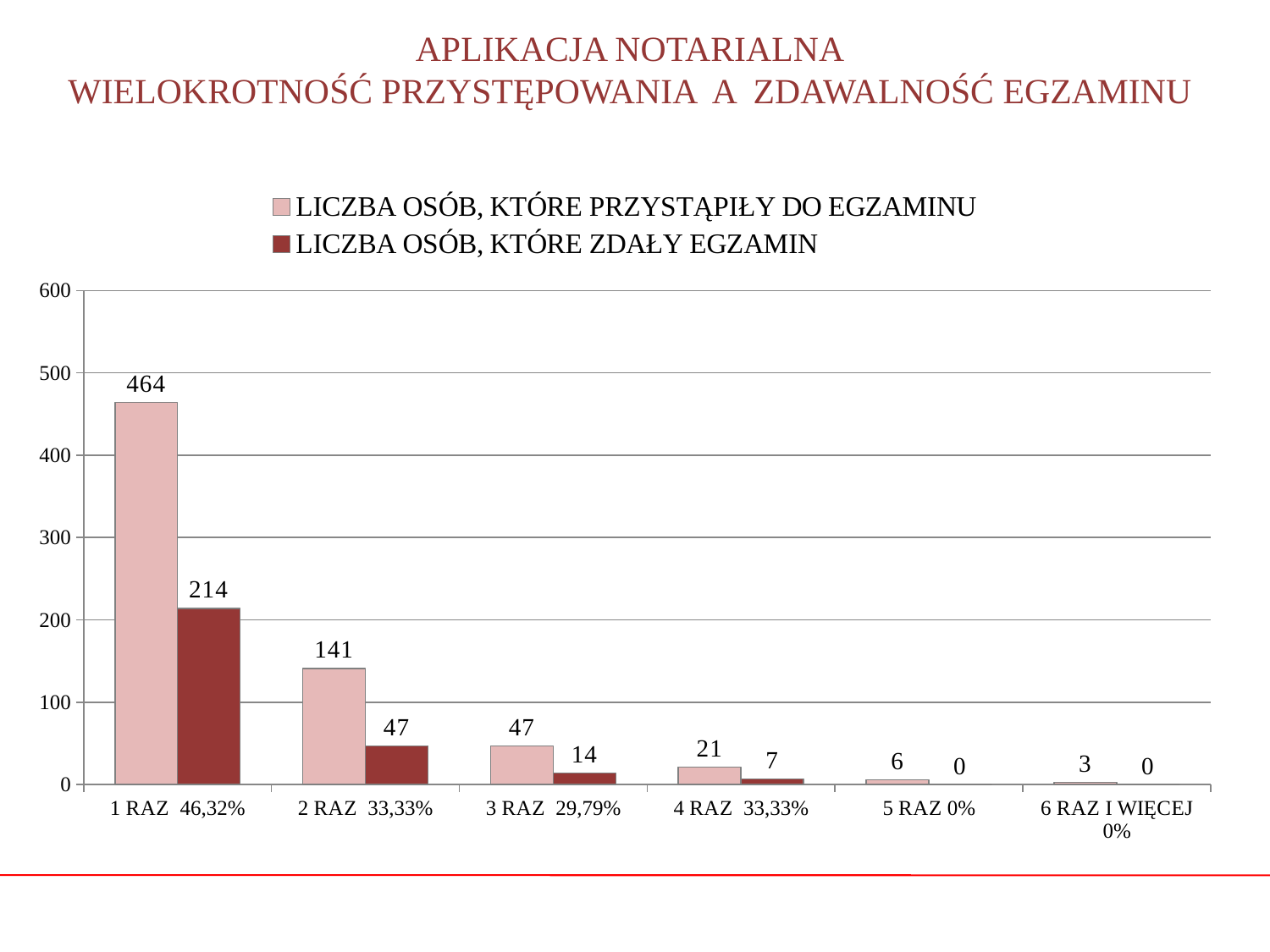
How many series does the legend list? 2 What is the difference between the number of people who took the exam and the number who passed in the '1 RAZ' category? 250 Which is larger: the number of people who passed in '3 RAZ' or the number who passed in '4 RAZ'? 3 RAZ How many categories are shown on the x axis? 6 What kind of chart is shown on the slide? Bar chart Which category has the lowest number of people who took the exam? 6 RAZ I WIĘCEJ Do the values for the number of people who took the exam rise or fall from left to right along the x axis? Fall How many people took the exam for the first time (1 RAZ) according to the 'LICZBA OSÓB, KTÓRE PRZYSTĄPIŁY DO EGZAMINU' series? 464 What pass rate is shown in the x-axis label for the '3 RAZ' category? 29,79% How many people took the exam in the '4 RAZ' category? 21 How many people passed the exam (LICZBA OSÓB, KTÓRE ZDAŁY EGZAMIN) in the '2 RAZ' category? 47 Which category has the highest number of people who took the exam? 1 RAZ